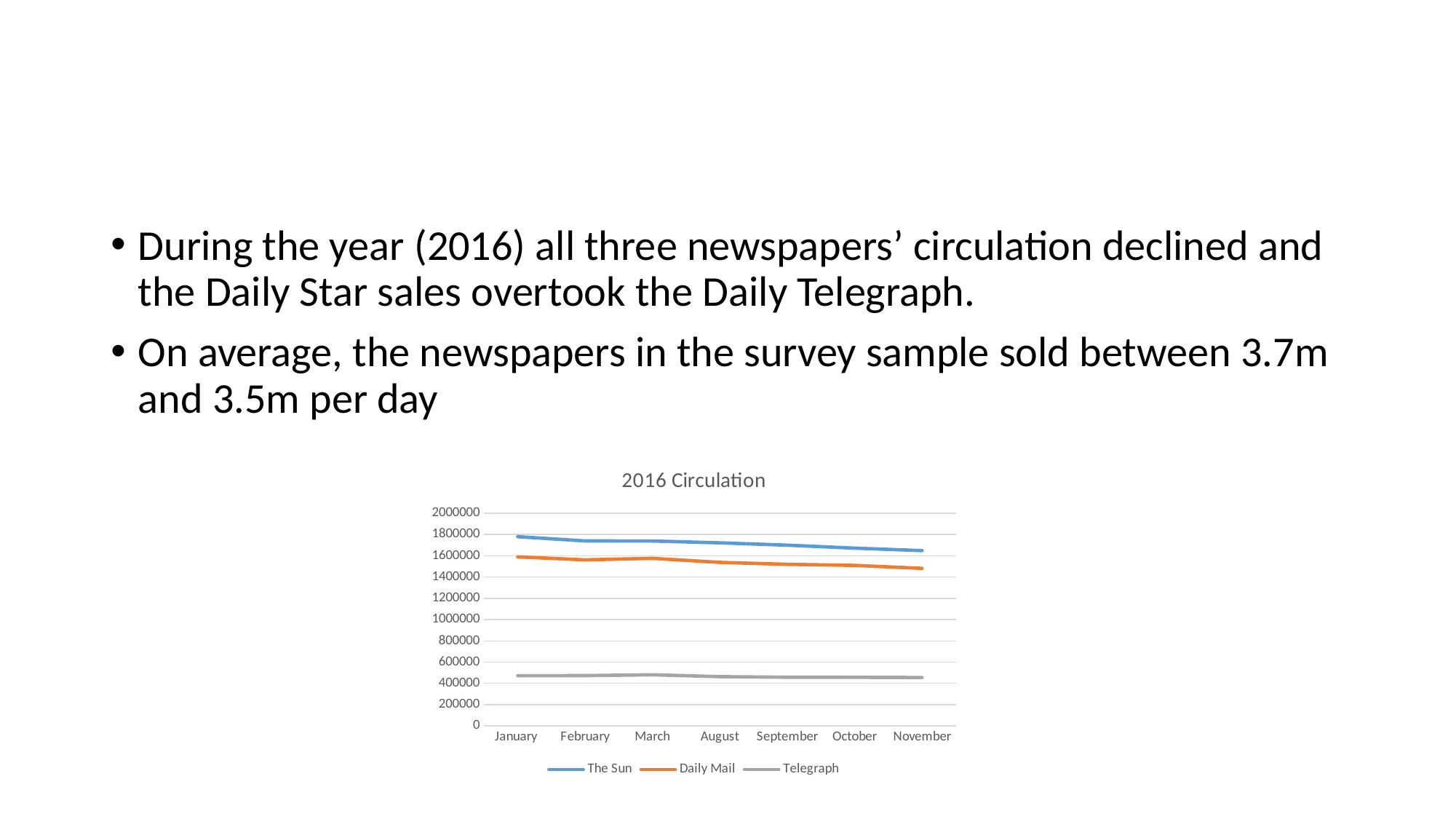
Is the value for the Telegraph in March greater or less than 600000? less What is the title of the chart? 2016 Circulation Is the value for The Sun in January greater or less than 1600000? greater Is the value for the Daily Mail in November greater or less than 1600000? less Which newspaper has the highest circulation throughout the chart? The Sun Which is larger in September, the circulation of the Daily Mail or the Telegraph? Daily Mail What kind of chart is shown on the slide? line chart How many series does the legend list? 3 Which series is drawn in orange? Daily Mail How many months are plotted along the x axis? 7 Which newspaper has the lowest circulation throughout the chart? Telegraph Does The Sun's circulation rise or fall from January to November? fall